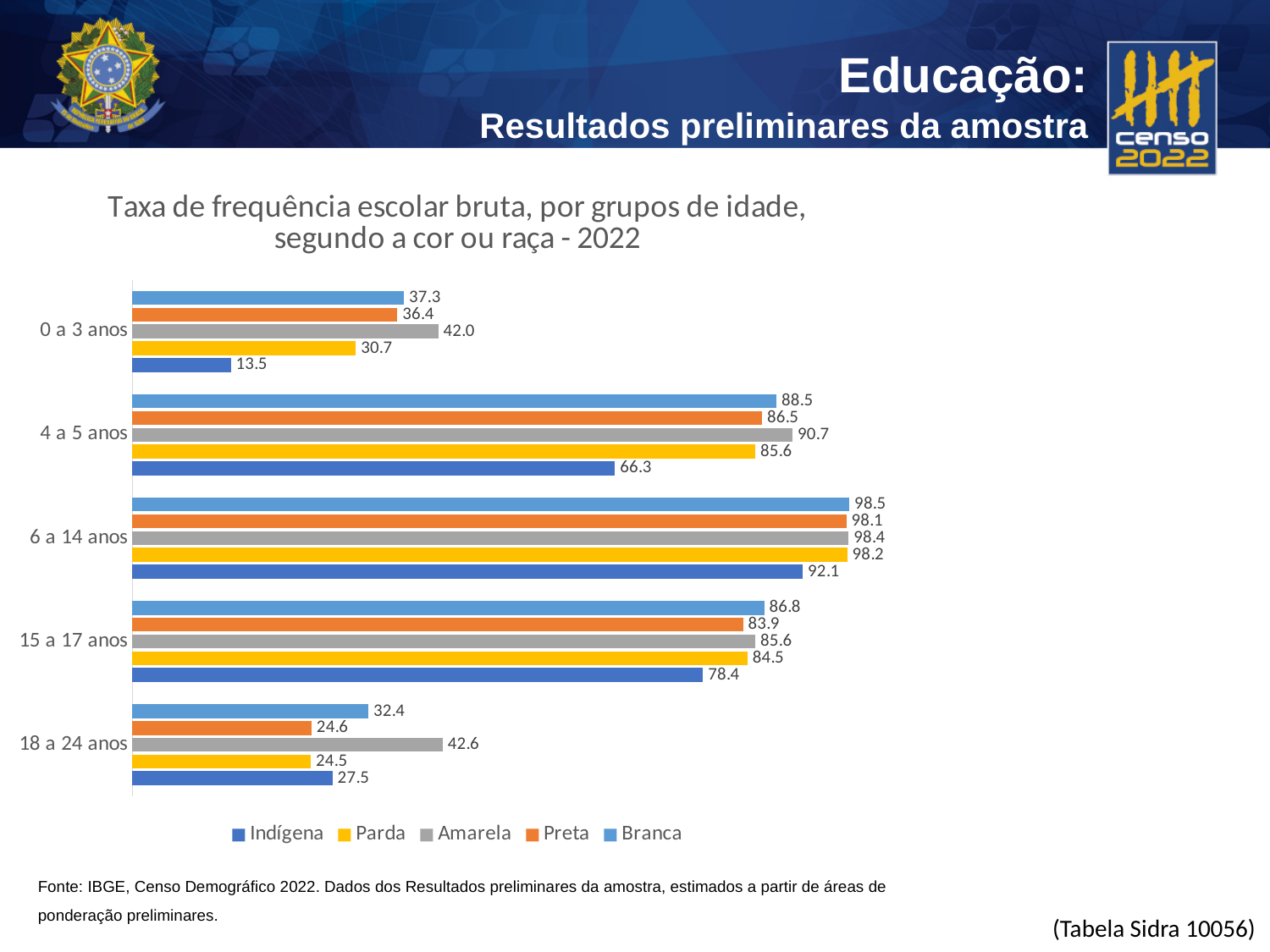
How many age groups are shown on the chart? 5 What is the value for Indígena in the 0 a 3 anos age group? 13.5 What is the difference between the Branca and Preta values in the 18 a 24 anos age group? 7.8 Which colour or race group has the highest value in the 4 a 5 anos age group? Amarela What is the difference between the Amarela and Indígena values in the 0 a 3 anos age group? 28.5 In the 18 a 24 anos age group, which is larger: the value for Indígena or the value for Parda? Indígena Which colour or race group has the lowest value in the 15 a 17 anos age group? Indígena Which age group has the highest value for Indígena? 6 a 14 anos What is the value for Branca in the 6 a 14 anos age group? 98.5 What kind of chart is shown on the slide? Bar chart How many series does the legend list? 5 What is the value for Amarela in the 18 a 24 anos age group? 42.6